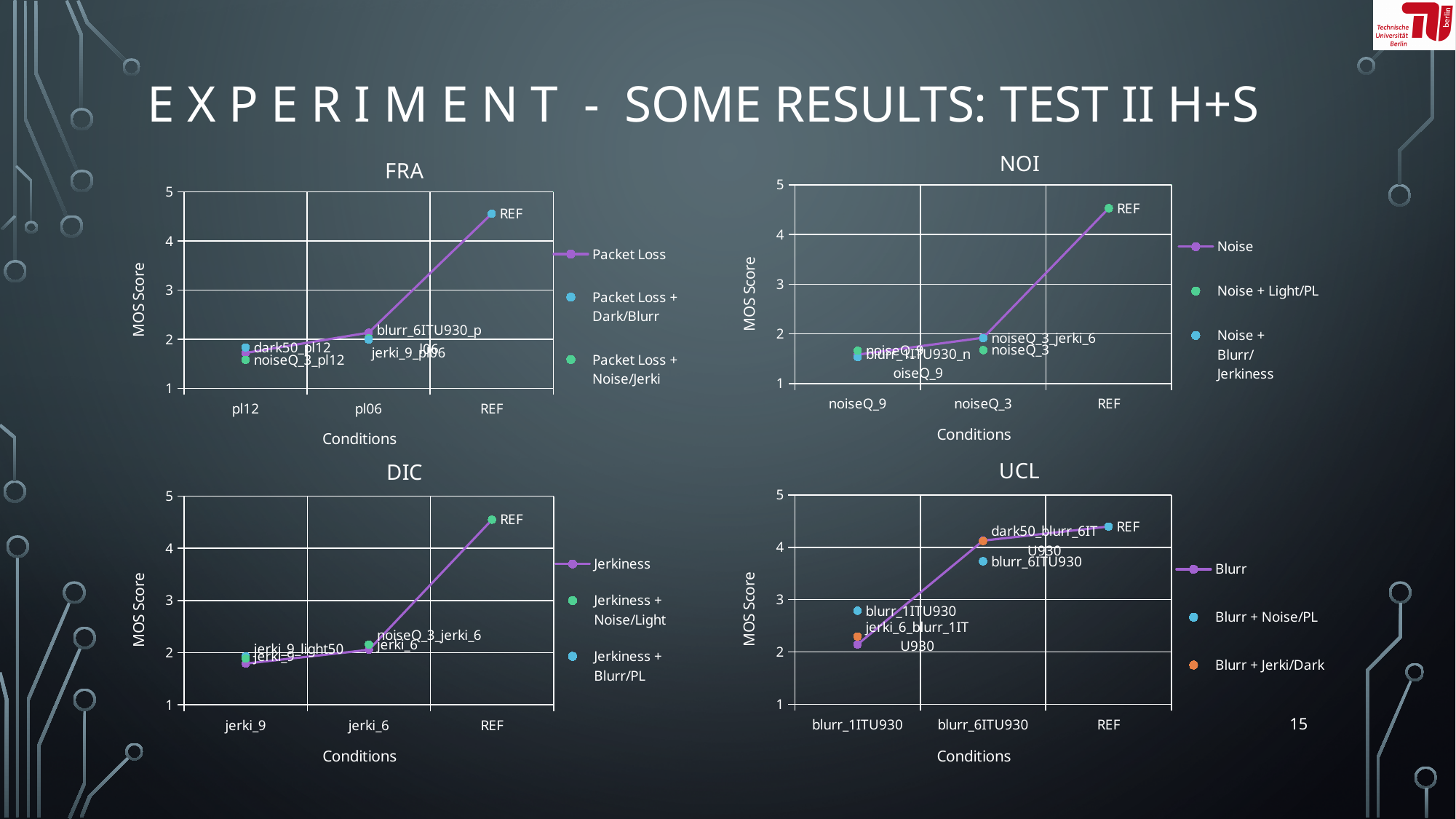
How many series does the legend of the NOI chart list? 3 In the NOI chart, which condition has the highest Noise MOS Score? REF In the UCL chart, is the Blurr value for blurr_6ITU930 greater or less than 3? greater In the FRA chart, is the Packet Loss value for REF greater or less than 4? greater How many series does the legend of the FRA chart list? 3 What kind of chart is the FRA chart? line chart What is the y-axis title of the DIC chart? MOS Score In the UCL chart, which condition has the lowest Blurr MOS Score? blurr_1ITU930 In the FRA chart, is the Packet Loss value for pl12 greater or less than 3? less In the FRA chart, do the Packet Loss values rise or fall from pl12 to REF? rise How many conditions are shown on the x axis of the FRA chart? 3